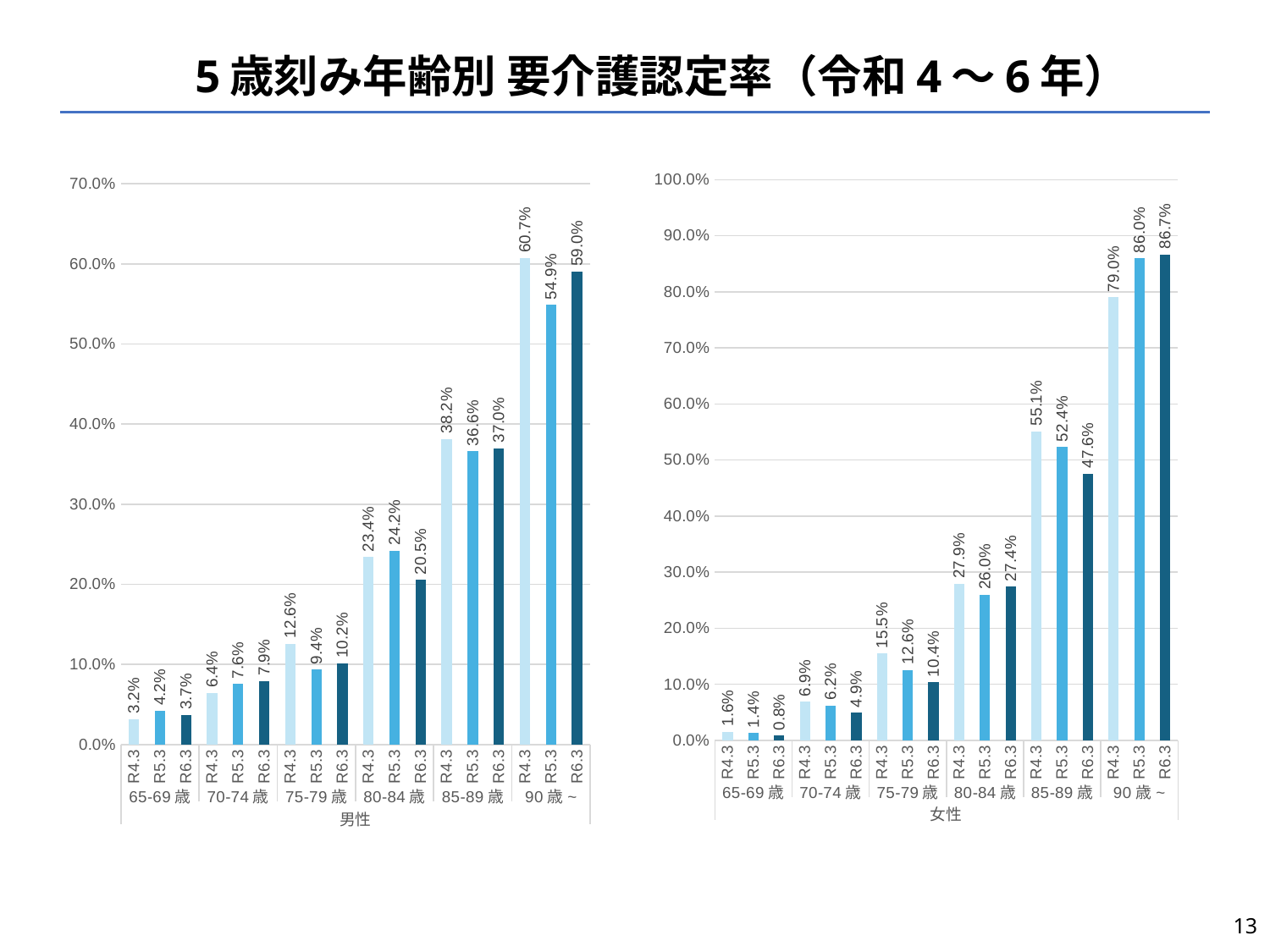
In the left chart (男性), what is the difference between R4.3 and R6.3 in the 85-89歳 group? 1.2% How many age groups are shown on the x axis of the left chart (男性)? 6 In the left chart (男性), do the R4.3 values rise or fall as the age groups increase from 65-69歳 to 90歳～? Rise In the left chart (男性), what is the value for R6.3 in the 90歳～ group? 59.0% In the right chart (女性), which bar has the highest value? R6.3 in 90歳～ (86.7%) In the left chart (男性), which is larger in the 80-84歳 group: R4.3 or R5.3? R5.3 In the right chart (女性), what is the value for R4.3 in the 85-89歳 group? 55.1% What type of chart is the right chart (女性)? Bar chart In the right chart (女性), which is larger in the 70-74歳 group: R4.3 or R6.3? R4.3 In the right chart (女性), which bar has the lowest value? R6.3 in 65-69歳 (0.8%) In the left chart (男性), what is the value for R5.3 in the 75-79歳 group? 9.4% In the right chart (女性), what is the difference between R6.3 and R4.3 in the 90歳～ group? 7.7%